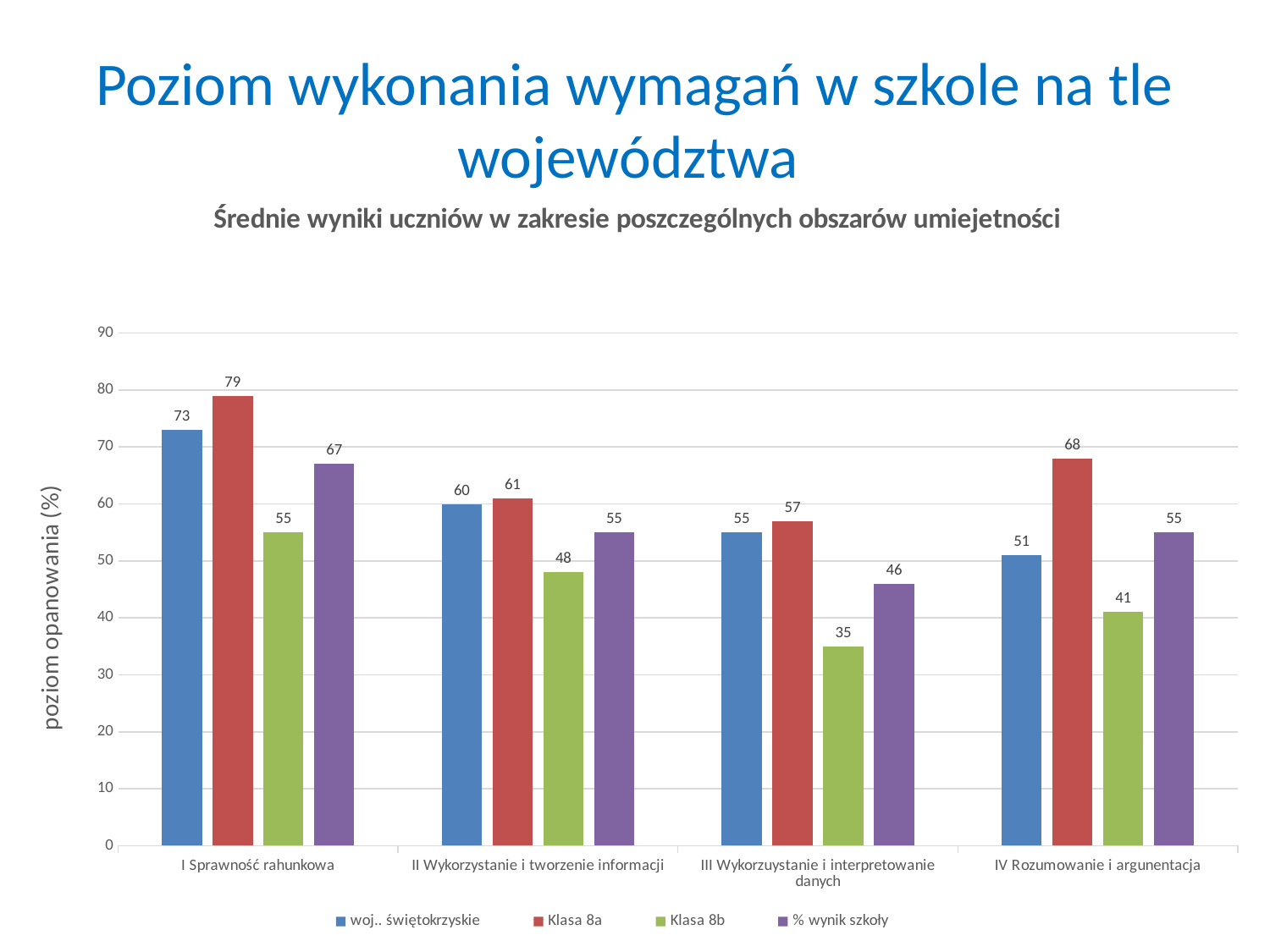
What is the label of the vertical axis? poziom opanowania (%) In which category does Klasa 8b have its lowest value? III Wykorzuystanie i interpretowanie danych What is the value for Klasa 8b in the category III Wykorzuystanie i interpretowanie danych? 35 What kind of chart is shown on the slide? bar chart What is the value for % wynik szkoły in the category II Wykorzystanie i tworzenie informacji? 55 In which category does Klasa 8a have its highest value? I Sprawność rahunkowa What is the value for woj.. świętokrzyskie in the category IV Rozumowanie i argunentacja? 51 How many categories are shown on the x axis? 4 Which is larger in the category I Sprawność rahunkowa: the value for woj.. świętokrzyskie or the value for % wynik szkoły? woj.. świętokrzyskie How many series does the legend list? 4 What is the difference between the Klasa 8a and Klasa 8b values in the category IV Rozumowanie i argunentacja? 27 What is the value for Klasa 8a in the category I Sprawność rahunkowa? 79